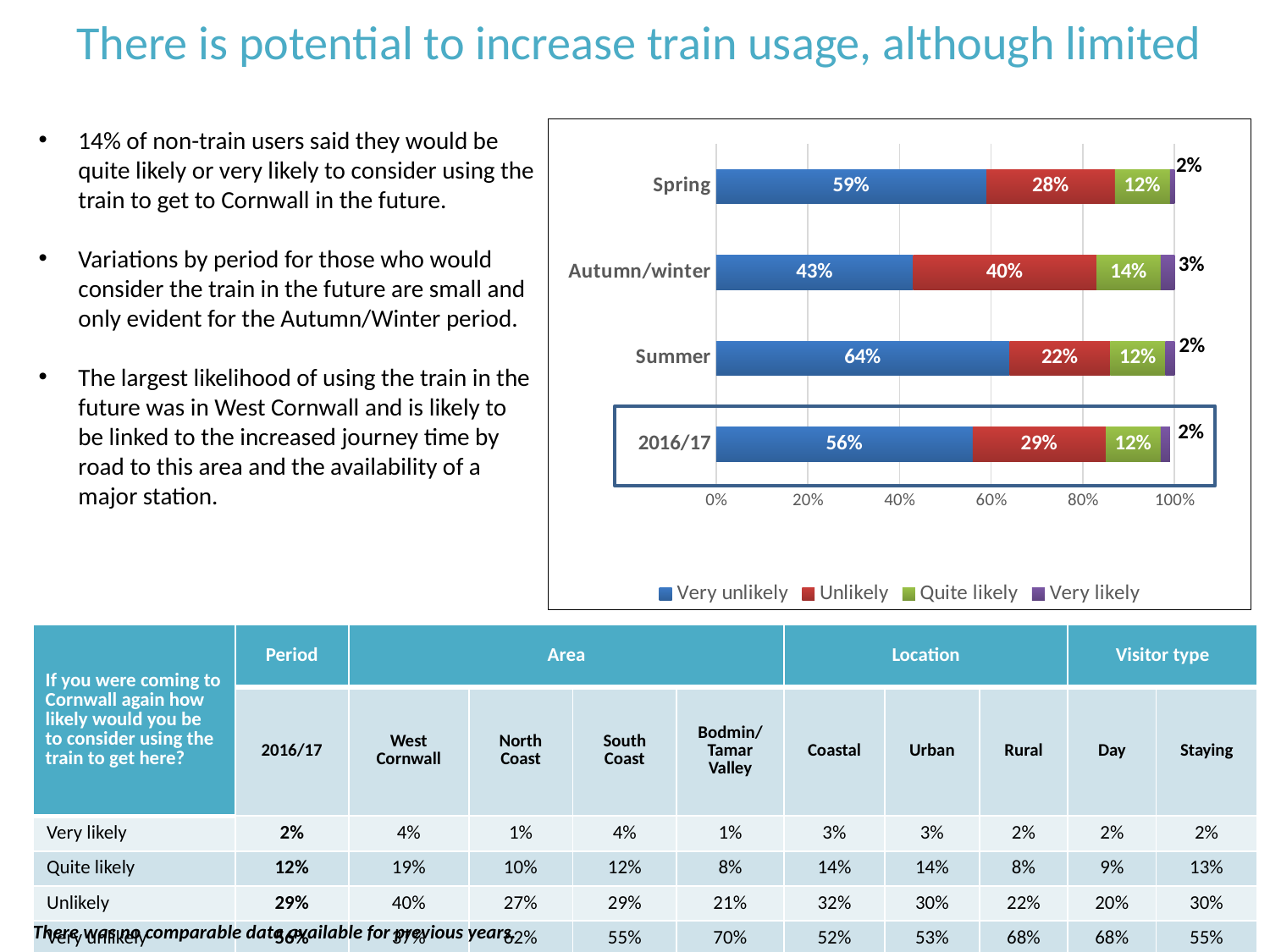
Which category has the lowest Very unlikely value? Autumn/winter What is the Very likely value for Autumn/winter? 3% What is the Quite likely value for Spring? 12% What is the Unlikely value for Autumn/winter? 40% What is the Very unlikely value for Summer? 64% Which category has the highest Very unlikely value? Summer Which is larger, the Unlikely value for Spring or the Unlikely value for Summer? Spring What kind of chart is shown on the slide? Stacked bar chart Which series is shown in blue in the chart? Very unlikely How many series does the chart legend list? 4 How many categories are plotted on the chart? 4 What is the difference between the Very unlikely values for Summer and Autumn/winter? 21%